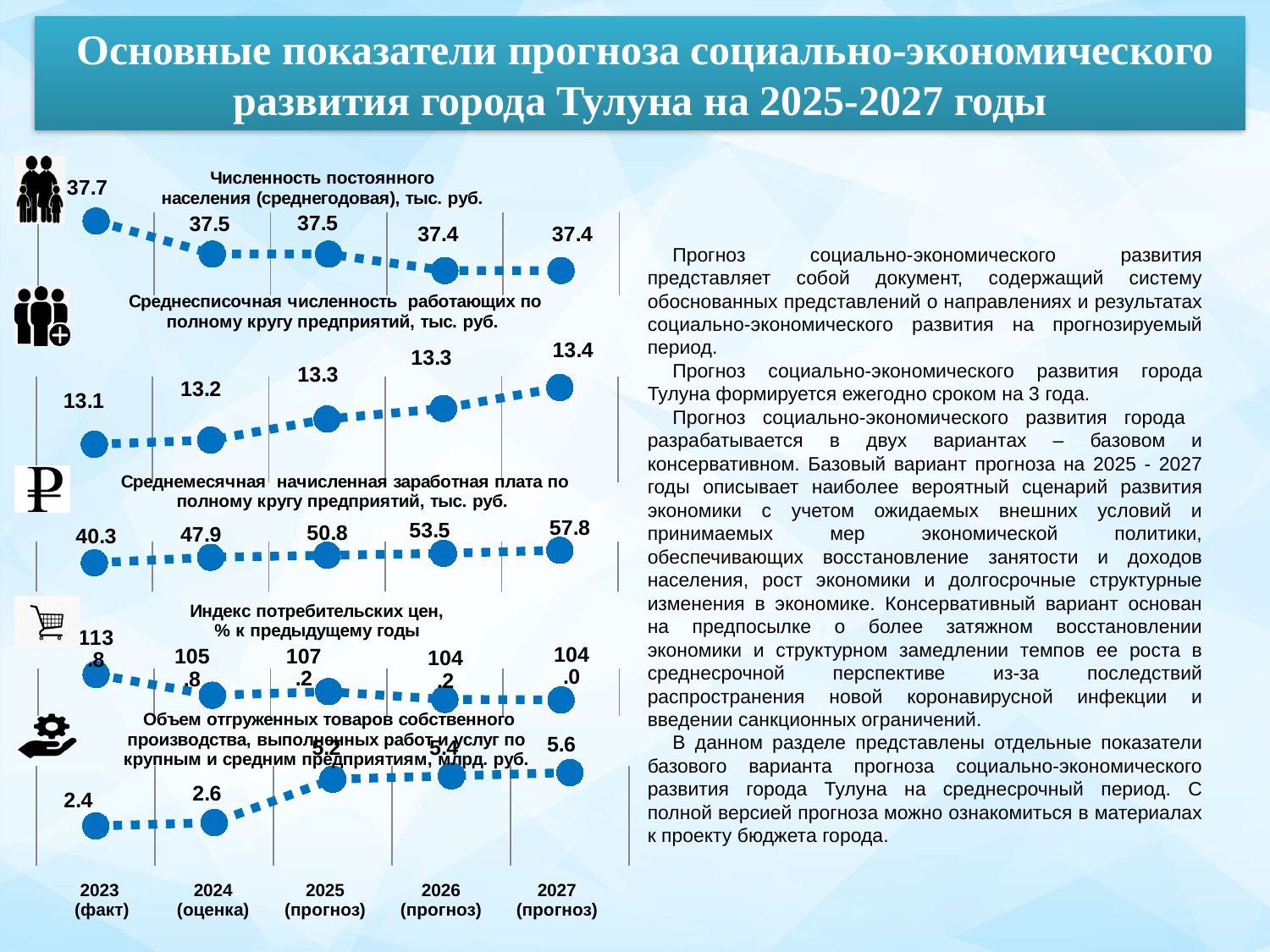
How many years (data points) does each chart on the slide show? 5 In the chart 'Среднемесячная начисленная заработная плата по полному кругу предприятий', what is the difference between the 2027 and 2023 values? 17.5 In the chart 'Индекс потребительских цен, % к предыдущему году', what is the value for 2023 (факт)? 113.8 In the chart 'Среднесписочная численность работающих по полному кругу предприятий', what is the value for 2025 (прогноз)? 13.3 In the chart 'Численность постоянного населения (среднегодовая)', do the values rise or fall from 2023 to 2027? fall In the chart 'Среднемесячная начисленная заработная плата по полному кругу предприятий', which year has the lowest value? 2023 (факт) In the chart 'Численность постоянного населения (среднегодовая)', what is the value for 2027 (прогноз)? 37.4 In the chart 'Среднесписочная численность работающих по полному кругу предприятий', which year has the highest value? 2027 (прогноз) In the chart 'Индекс потребительских цен, % к предыдущему году', which is larger: the value for 2025 or the value for 2026? 2025 In the chart 'Объем отгруженных товаров собственного производства', what is the value for 2027 (прогноз)? 5.6 In the chart 'Численность постоянного населения (среднегодовая)', what is the value for 2023 (факт)? 37.7 In the chart 'Среднемесячная начисленная заработная плата по полному кругу предприятий', what is the value for 2024 (оценка)? 47.9